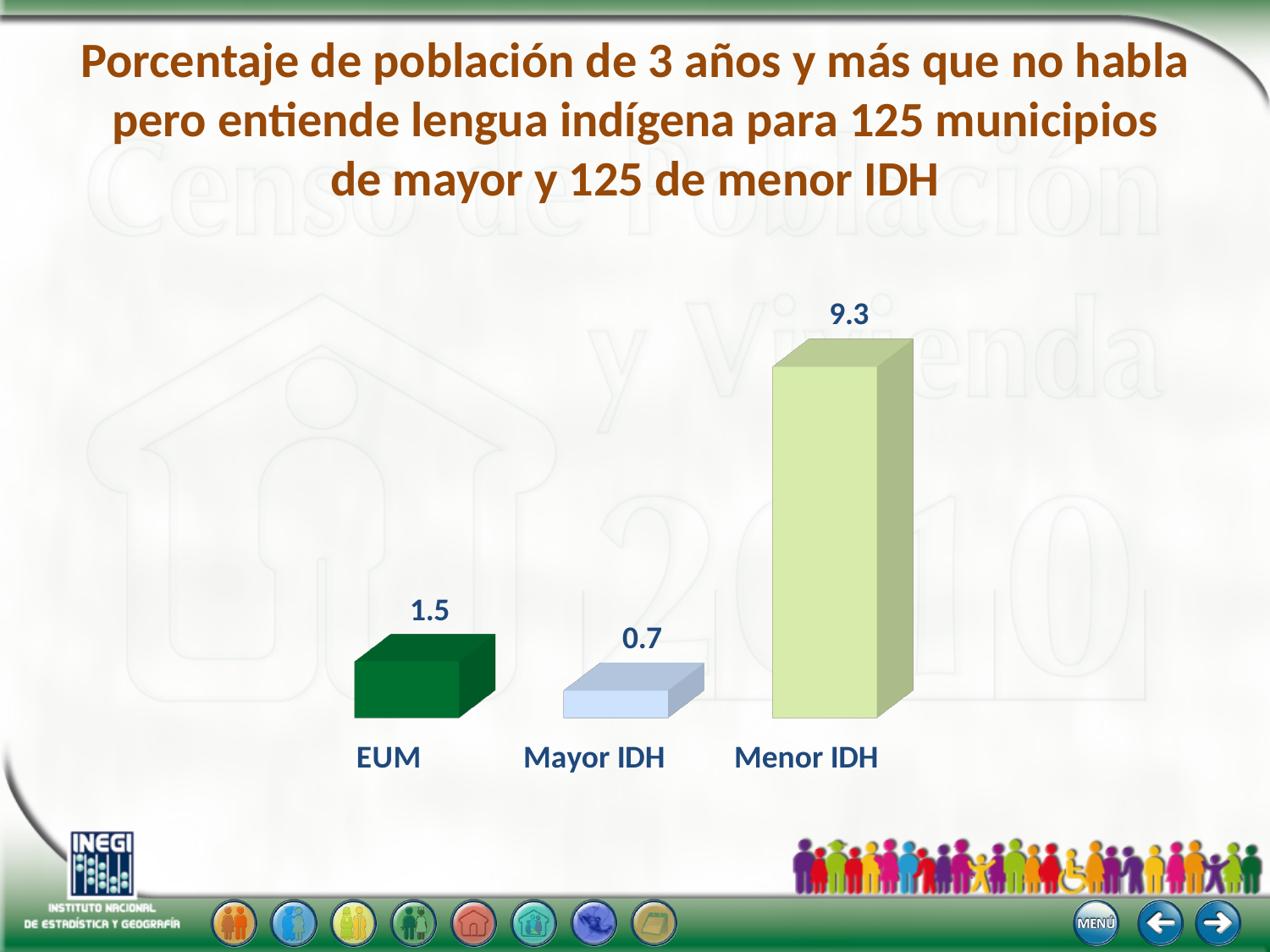
What is the value for Menor IDH? 9.3 How many categories are shown in the chart? 3 What is the difference between the values for Menor IDH and Mayor IDH? 8.6 What colour is the bar for EUM? Dark green Which is larger, the value for EUM or the value for Mayor IDH? EUM Which category has the lowest value? Mayor IDH Which category has the highest value? Menor IDH What is the value for Mayor IDH? 0.7 What kind of chart is shown on the slide? Bar chart What is the title of the chart? Porcentaje de población de 3 años y más que no habla pero entiende lengua indígena para 125 municipios de mayor y 125 de menor IDH What is the difference between the values for EUM and Mayor IDH? 0.8 What is the value for EUM? 1.5